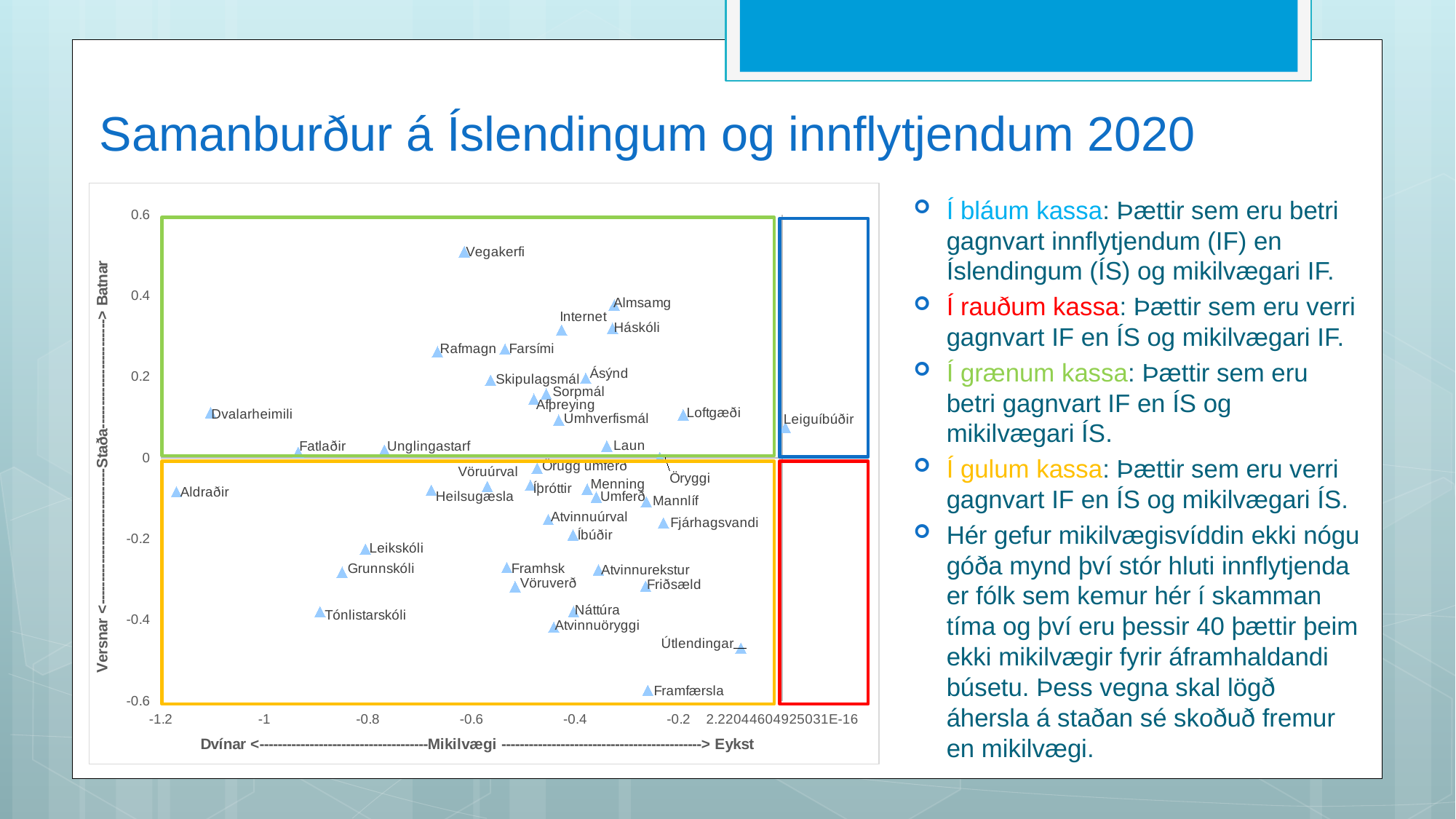
Which labelled point is furthest to the right on the horizontal (Mikilvægi) axis? Leiguíbúðir Is the vertical-axis value for Framfærsla greater or less than -0.4? less Which labelled point has the lowest value on the vertical (Staða) axis? Framfærsla Which point is higher on the vertical axis, Grunnskóli or Tónlistarskóli? Grunnskóli What kind of chart is shown on the slide? scatter chart Which labelled point has the highest value on the vertical (Staða) axis? Vegakerfi Is the horizontal-axis value for Tónlistarskóli greater or less than -0.8? less Which coloured box on the chart contains the point Leiguíbúðir? the blue box Is the vertical-axis value for Almsamg greater or less than 0.2? greater Which labelled point is furthest to the left on the horizontal (Mikilvægi) axis? Aldraðir Which point is higher on the vertical axis, Vegakerfi or Almsamg? Vegakerfi